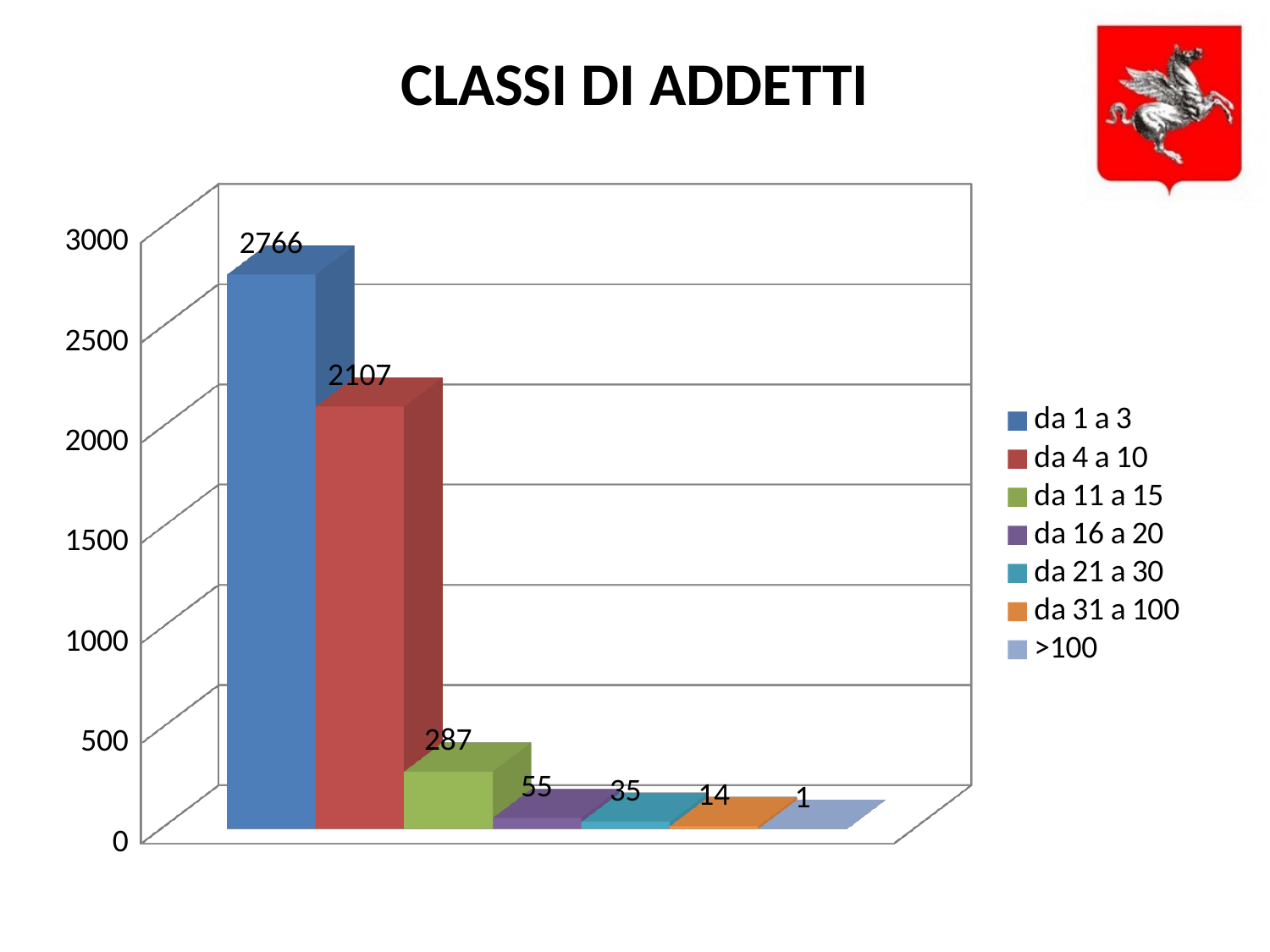
Which class has the highest value? da 1 a 3 What is the difference between the values for 'da 1 a 3' and 'da 4 a 10'? 659 Which class has the lowest value? >100 What is the value for the '>100' class? 1 How many classes are shown in the legend? 7 What is the value for the 'da 11 a 15' class? 287 What kind of chart is shown on the slide? bar chart What is the value for the 'da 1 a 3' class? 2766 What is the value for the 'da 4 a 10' class? 2107 Is the value for 'da 4 a 10' greater or less than 2000? greater What is the title of the chart? CLASSI DI ADDETTI Which is larger, the value for 'da 16 a 20' or the value for 'da 21 a 30'? da 16 a 20